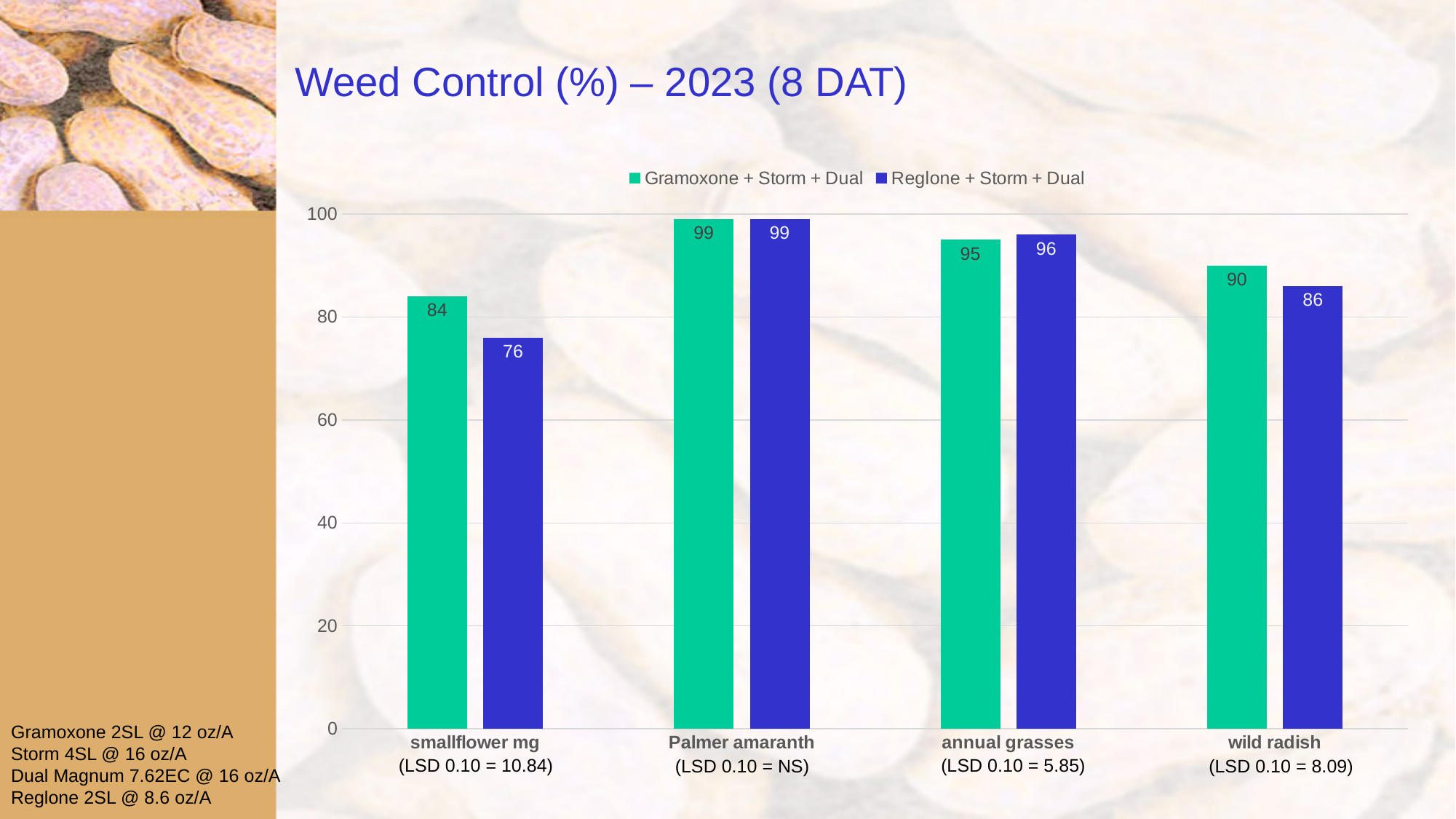
What kind of chart is shown on the slide? bar chart What is the weed control value for Reglone + Storm + Dual on annual grasses? 96 What is the weed control value for Reglone + Storm + Dual on wild radish? 86 How many weed categories are shown on the x axis? 4 For wild radish, which treatment has the larger value, Gramoxone + Storm + Dual or Reglone + Storm + Dual? Gramoxone + Storm + Dual How many series does the legend list? 2 What is the weed control value for Gramoxone + Storm + Dual on smallflower mg? 84 Is the value for Reglone + Storm + Dual on smallflower mg greater or less than 80? less Which weed category has the lowest value for Reglone + Storm + Dual? smallflower mg What is the title of the chart on the slide? Weed Control (%) – 2023 (8 DAT) What is the difference between the Gramoxone + Storm + Dual and Reglone + Storm + Dual values for smallflower mg? 8 Which weed category has the highest value for Gramoxone + Storm + Dual? Palmer amaranth